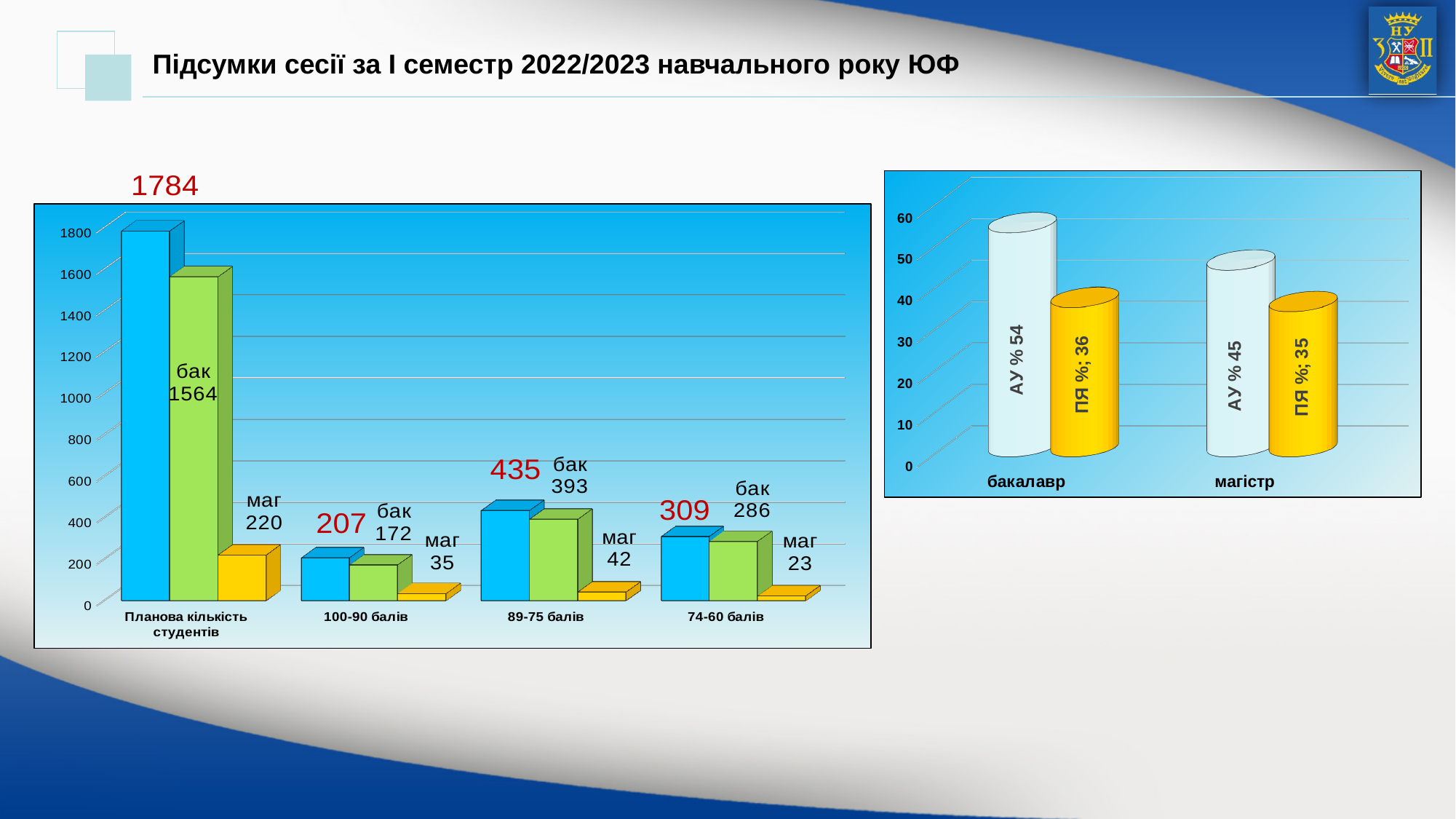
On the left chart, which of the score categories (excluding the planned number) has the highest red total value? 89-75 балів On the left chart, is the 'бак' value for '89-75 балів' larger or smaller than the 'бак' value for '74-60 балів'? larger What kind of chart is the left chart? bar chart On the left chart, what is the red total value shown above the '74-60 балів' category? 309 On the left chart, which category has the lowest 'маг' value? 74-60 балів On the right chart, what is the difference between the 'АУ %' values for 'бакалавр' and 'магістр'? 9 On the left chart, what is the value labelled for 'маг' in the '89-75 балів' category? 42 On the right chart, what is the 'ПЯ %' value for 'магістр'? 35 On the left chart, how many categories are shown on the x axis? 4 On the left chart, what is the difference between the 'бак' value and the 'маг' value in the '100-90 балів' category? 137 On the left chart, what is the value labelled for 'бак' in the 'Планова кількість студентів' category? 1564 On the right chart, what is the 'АУ %' value for 'бакалавр'? 54